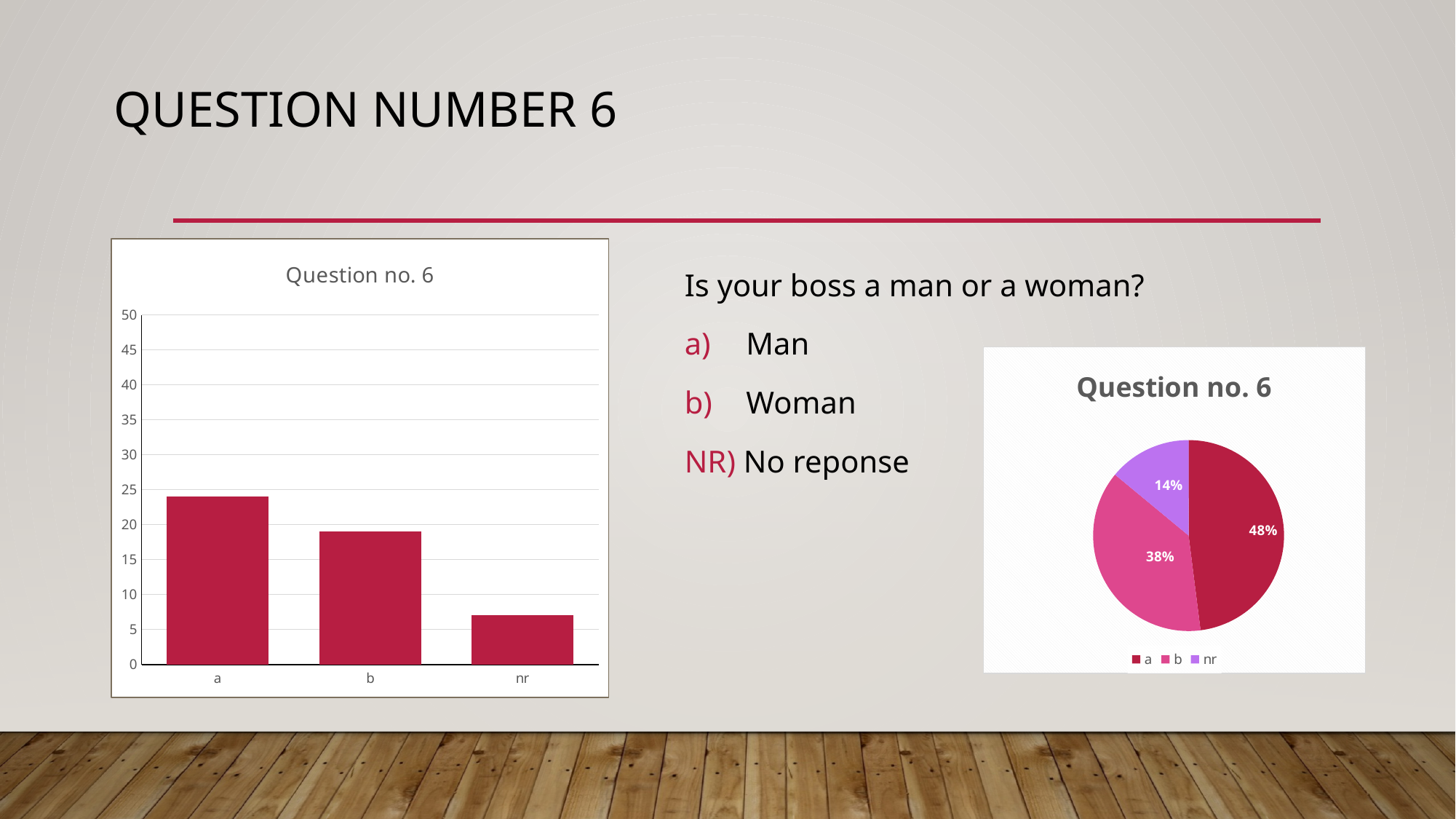
In the bar chart on the left, is the value for b greater or less than 20? less What kind of chart is the chart on the left of the slide? bar chart In the bar chart on the left, is the value for a greater or less than 20? greater In the bar chart on the left, which category has the lowest bar? nr In the pie chart on the right, what share does slice nr have? 14% In the bar chart on the left, which category has the highest bar? a In the bar chart on the left, is the value for nr greater or less than 10? less How many categories are shown in the bar chart on the left? 3 How many entries does the legend of the pie chart on the right list? 3 In the pie chart on the right, what share does slice a have? 48% What kind of chart is the chart on the right of the slide? pie chart In the pie chart on the right, what is the difference between the shares of a and b? 10%